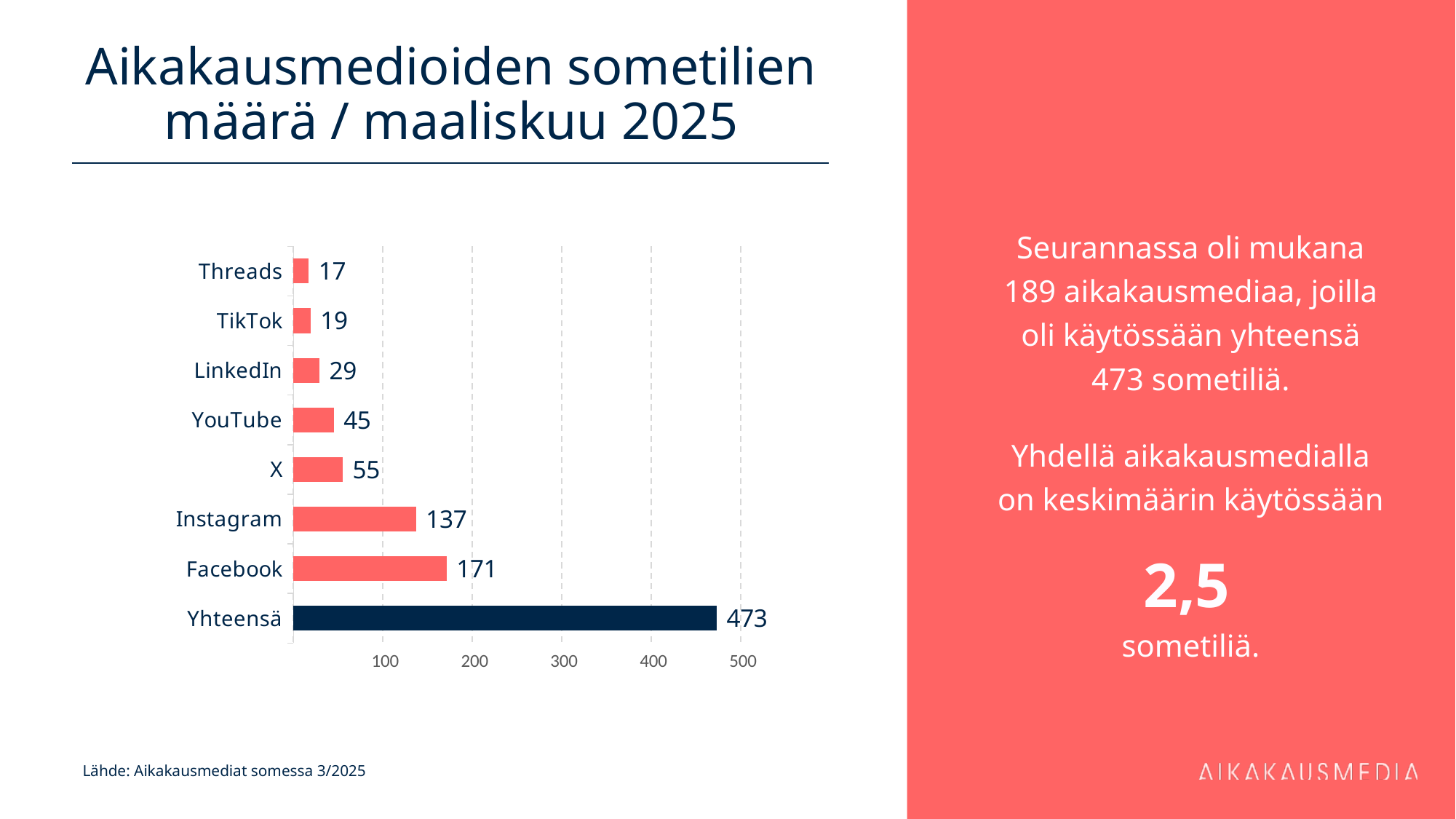
Which platform has the lowest value? Threads Is the value for Instagram greater or less than 100? greater What is the difference between the values for X and YouTube? 10 What is the value for Facebook? 171 Excluding the Yhteensä total bar, which platform has the highest value? Facebook What kind of chart is shown on the slide? Bar chart How many bars are shown in the chart? 8 What is the difference between the values for Facebook and Instagram? 34 Which is larger, the value for LinkedIn or the value for TikTok? LinkedIn What is the value shown for Yhteensä? 473 What is the value for Threads? 17 What is the value for Instagram? 137